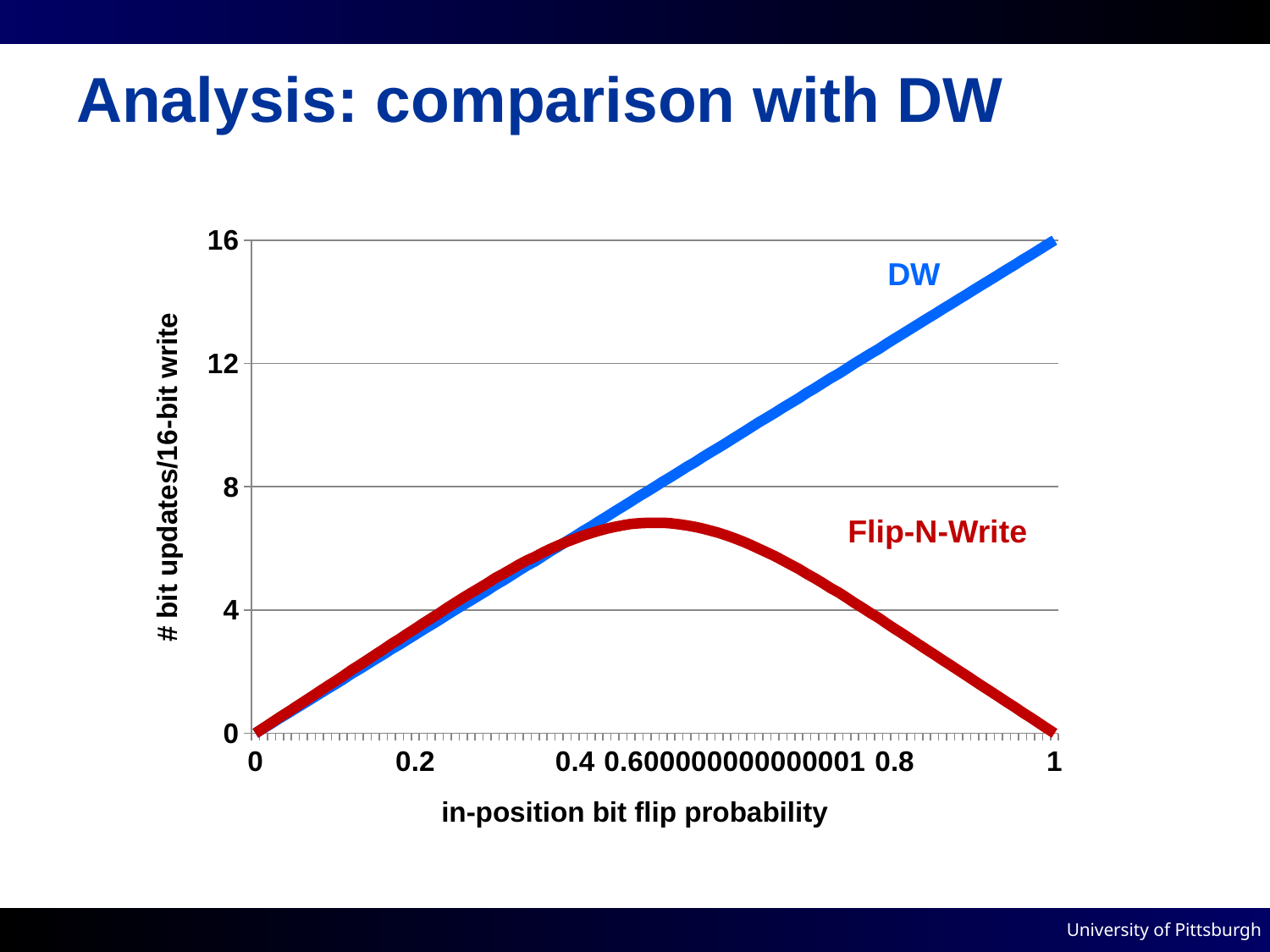
What is the value of Flip-N-Write at an in-position bit flip probability of 1? 0 What is the title of the x axis? in-position bit flip probability How many series are plotted on the chart? 2 At a bit flip probability of 0.8, which series has the larger value, DW or Flip-N-Write? DW What is the value of DW at an in-position bit flip probability of 0? 0 Is the value for Flip-N-Write at a bit flip probability of 0.6 greater or less than 4? greater Is the value for Flip-N-Write at a bit flip probability of 0.8 greater or less than 8? less What kind of chart is shown on the slide? line chart Is the value for DW at a bit flip probability of 0.2 greater or less than 4? less What is the value of DW at an in-position bit flip probability of 1? 16 Does the DW line rise or fall as the in-position bit flip probability increases from 0 to 1? rises